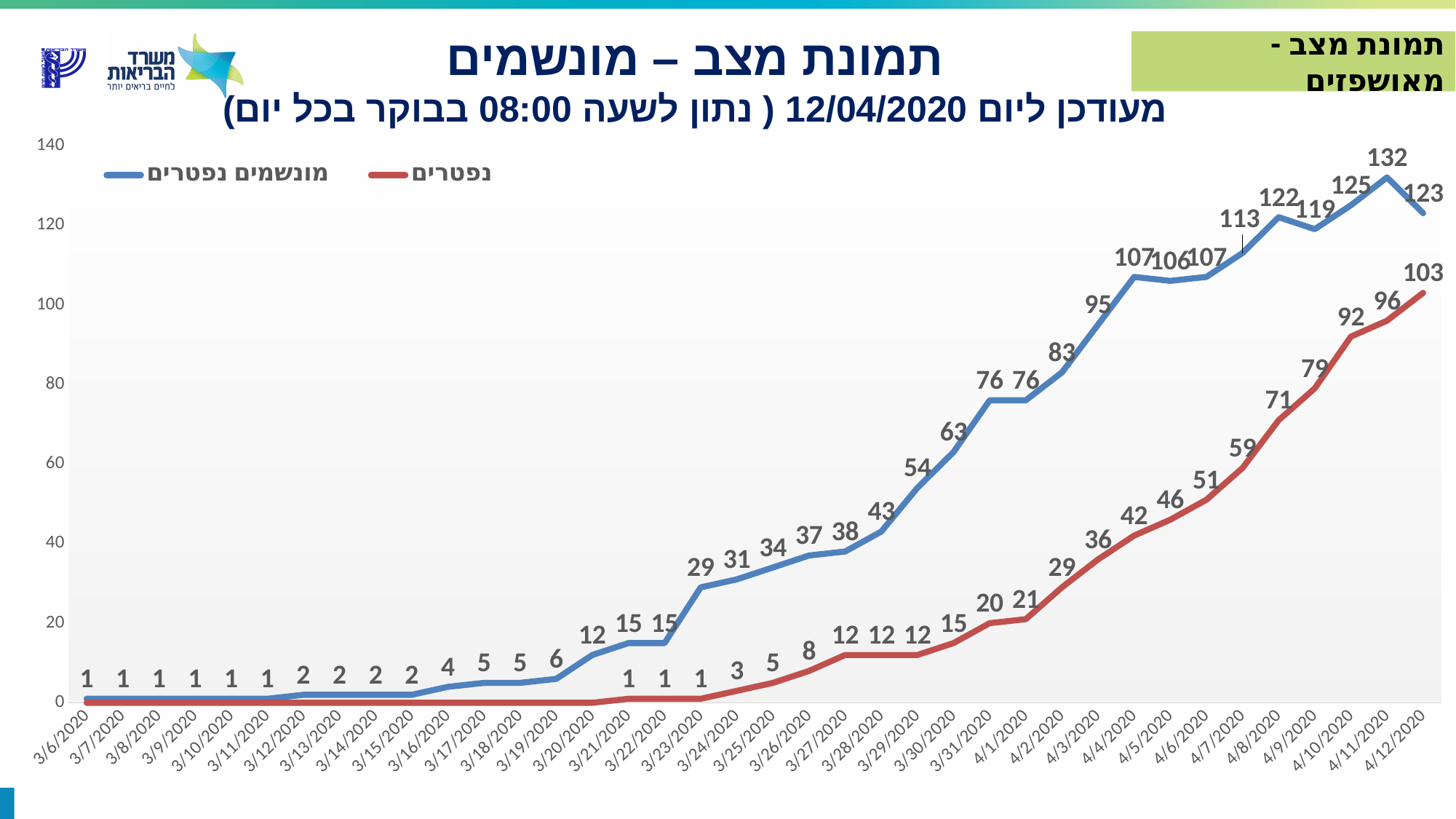
What colour is the line for נפטרים? red What is the value of the red line (נפטרים) on 4/2/2020? 29 On 4/8/2020, which is larger: the blue line (מונשמים) or the red line (נפטרים)? the blue line (מונשמים) What is the difference between the blue line (מונשמים) and the red line (נפטרים) on 4/12/2020? 20 How many dates are shown on the x axis? 38 What is the value of the blue line (מונשמים) on 3/23/2020? 29 Does the red line (נפטרים) generally rise or fall from 3/21/2020 to 4/12/2020? rise What is the value of the blue line (מונשמים) on 4/11/2020? 132 On which date does the blue line (מונשמים) reach its highest value? 4/11/2020 What is the value of the red line (נפטרים) on 4/12/2020? 103 How many series does the legend list? 2 What type of chart is shown on the slide? line chart